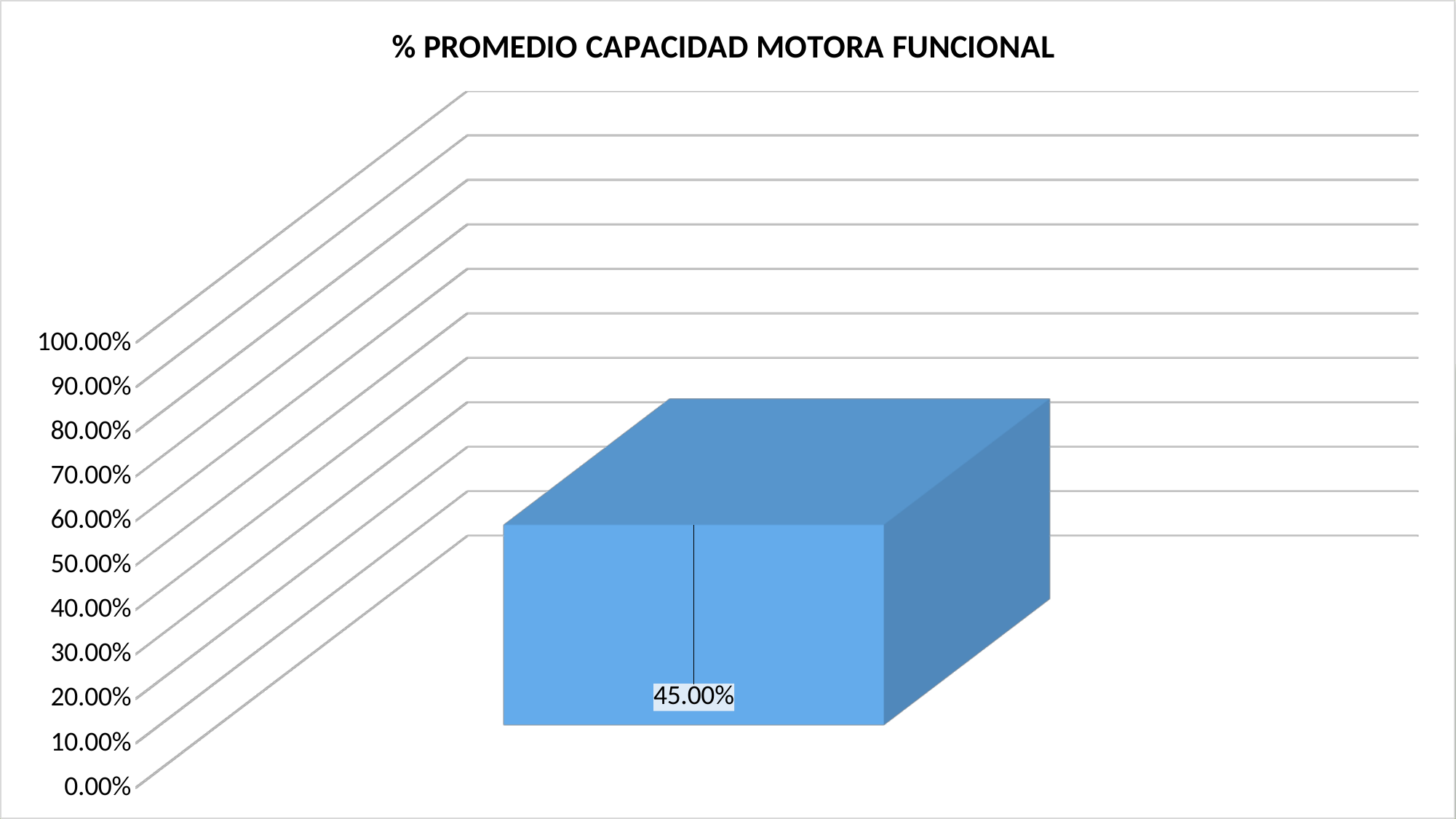
What is the highest value shown on the vertical axis? 100.00% Is the value shown on the bar greater or less than 40.00%? greater What value is printed on the bar in the chart? 45.00% How many bars are plotted in the chart? 1 What is the title of the chart? % PROMEDIO CAPACIDAD MOTORA FUNCIONAL What is the lowest value shown on the vertical axis? 0.00% Is the value shown on the bar greater or less than 50.00%? less What kind of chart is shown on the slide? bar chart